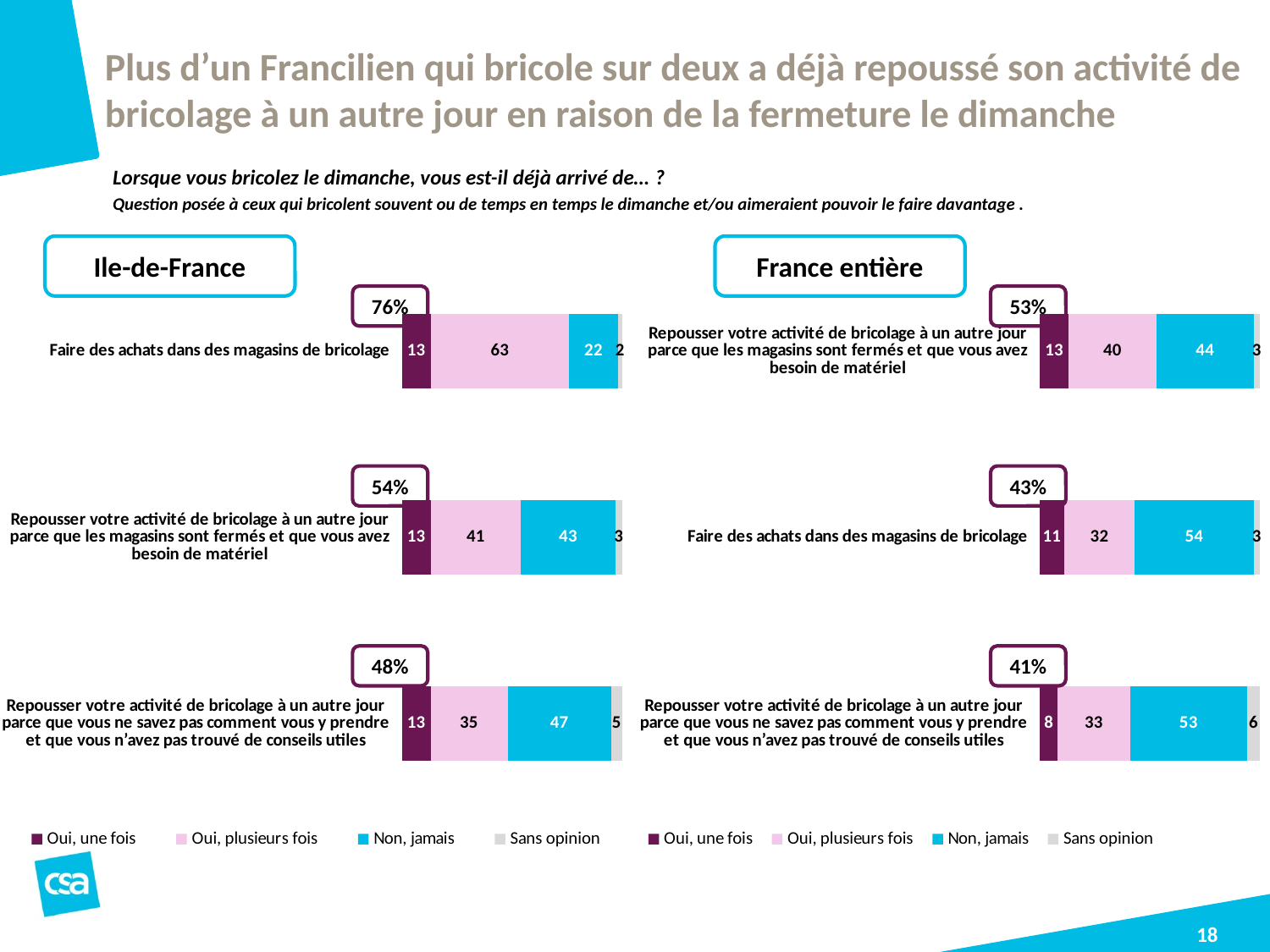
In the Ile-de-France chart, what is the value for "Oui, plusieurs fois" for "Faire des achats dans des magasins de bricolage"? 63 What kind of chart is the Ile-de-France chart? Stacked bar chart In the France entière chart, which is larger: the "Oui, plusieurs fois" value for "Repousser votre activité de bricolage à un autre jour parce que les magasins sont fermés et que vous avez besoin de matériel" or for "Faire des achats dans des magasins de bricolage"? Repousser votre activité de bricolage à un autre jour parce que les magasins sont fermés et que vous avez besoin de matériel In the Ile-de-France chart, what is the value for "Non, jamais" for "Repousser votre activité de bricolage à un autre jour parce que vous ne savez pas comment vous y prendre et que vous n'avez pas trouvé de conseils utiles"? 47 In the France entière chart, what percentage is shown in the box above the bar for "Faire des achats dans des magasins de bricolage"? 43% In the Ile-de-France chart, what is the difference between the "Non, jamais" values for "Repousser votre activité de bricolage à un autre jour parce que vous ne savez pas comment vous y prendre et que vous n'avez pas trouvé de conseils utiles" and "Faire des achats dans des magasins de bricolage"? 25 In the Ile-de-France chart, which category has the highest "Oui, plusieurs fois" value? Faire des achats dans des magasins de bricolage In the France entière chart, what is the value for "Non, jamais" for "Faire des achats dans des magasins de bricolage"? 54 In the France entière chart, what is the value for "Oui, une fois" for "Repousser votre activité de bricolage à un autre jour parce que vous ne savez pas comment vous y prendre et que vous n'avez pas trouvé de conseils utiles"? 8 How many series does the legend of the France entière chart list? 4 In the France entière chart, which category has the lowest "Oui, une fois" value? Repousser votre activité de bricolage à un autre jour parce que vous ne savez pas comment vous y prendre et que vous n'avez pas trouvé de conseils utiles How many categories does the Ile-de-France chart show? 3